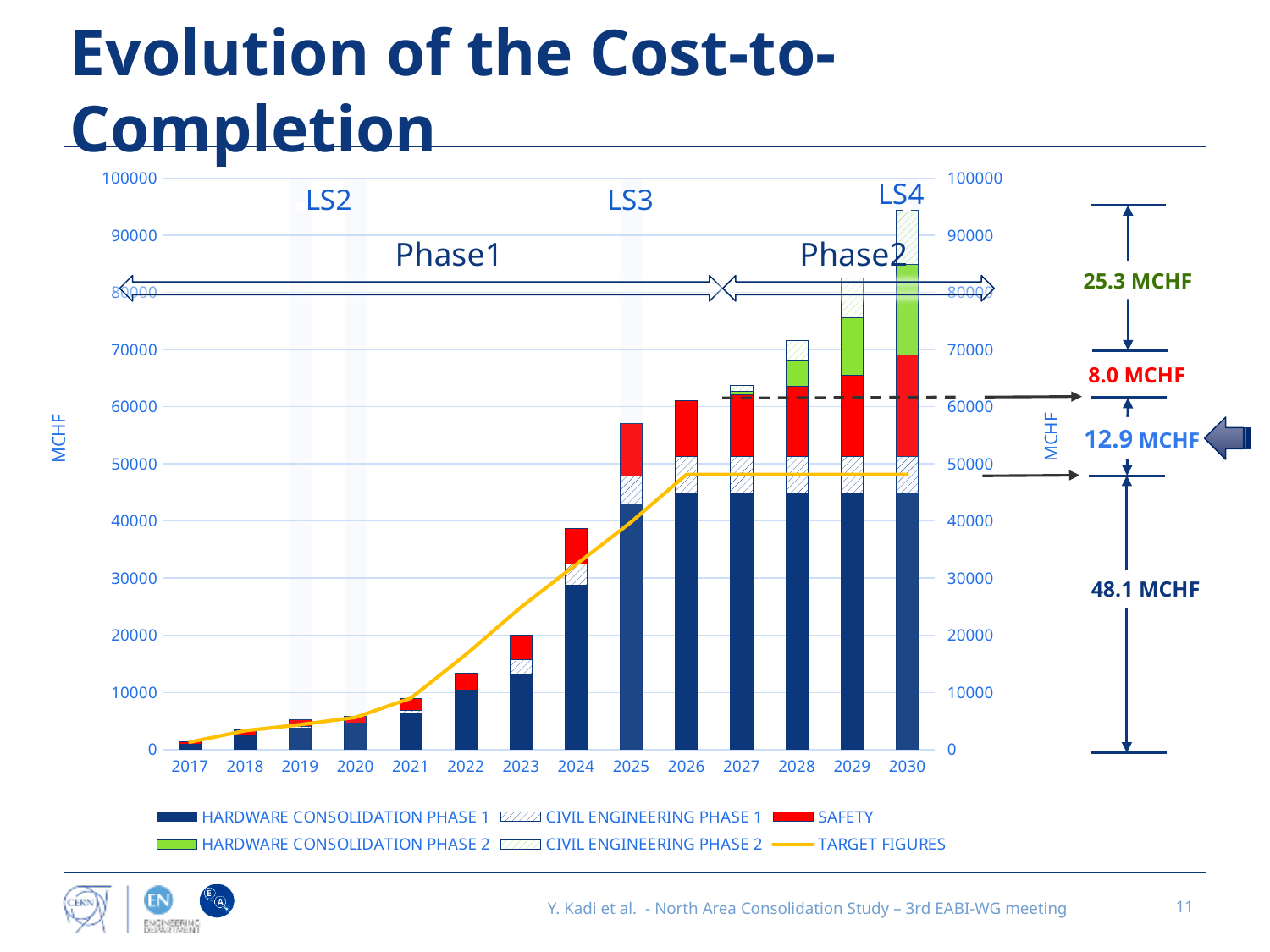
Is the total stacked bar for 2017 greater or less than 10000? less How many years are shown along the x axis of the chart? 14 Do the stacked bar totals rise or fall from 2017 to 2030? rise Which year has the shortest stacked bar? 2017 Which legend entry is drawn as a yellow line rather than a bar? TARGET FIGURES What kind of chart is shown on the slide? stacked bar chart with a line (combination bar and line chart) Is the total stacked bar for 2030 greater or less than 90000? greater Which year has the larger stacked bar total, 2028 or 2029? 2029 How many series does the chart legend list? 6 What is the label on the vertical axis of the chart? MCHF Is the total stacked bar for 2025 greater or less than 50000? greater Which year has the tallest stacked bar? 2030